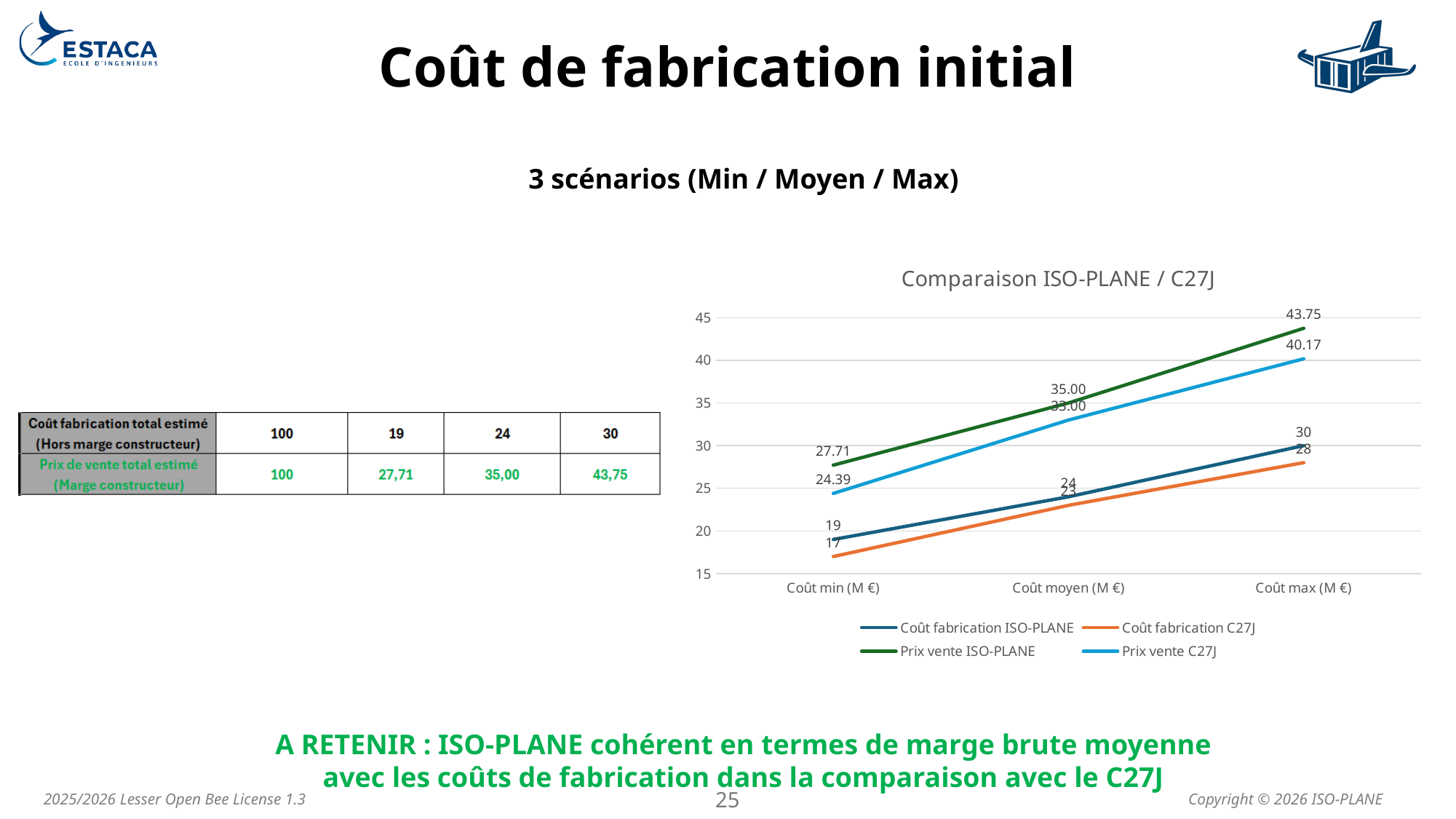
What is the title of the chart? Comparaison ISO-PLANE / C27J What is the value of Coût fabrication C27J at Coût min (M €)? 17 What type of chart is shown on the slide? line chart Does the Coût fabrication ISO-PLANE series rise or fall from Coût min (M €) to Coût max (M €)? rise What is the value of Prix vente ISO-PLANE at Coût max (M €)? 43.75 What is the difference between Prix vente ISO-PLANE and Prix vente C27J at Coût min (M €)? 3.32 How many categories are shown on the x axis of the chart? 3 Which series has the highest value at Coût max (M €)? Prix vente ISO-PLANE Which series has the lowest value at Coût min (M €)? Coût fabrication C27J What is the value of Prix vente C27J at Coût moyen (M €)? 33.00 What is the value of Coût fabrication ISO-PLANE at Coût max (M €)? 30 How many series does the chart legend list? 4